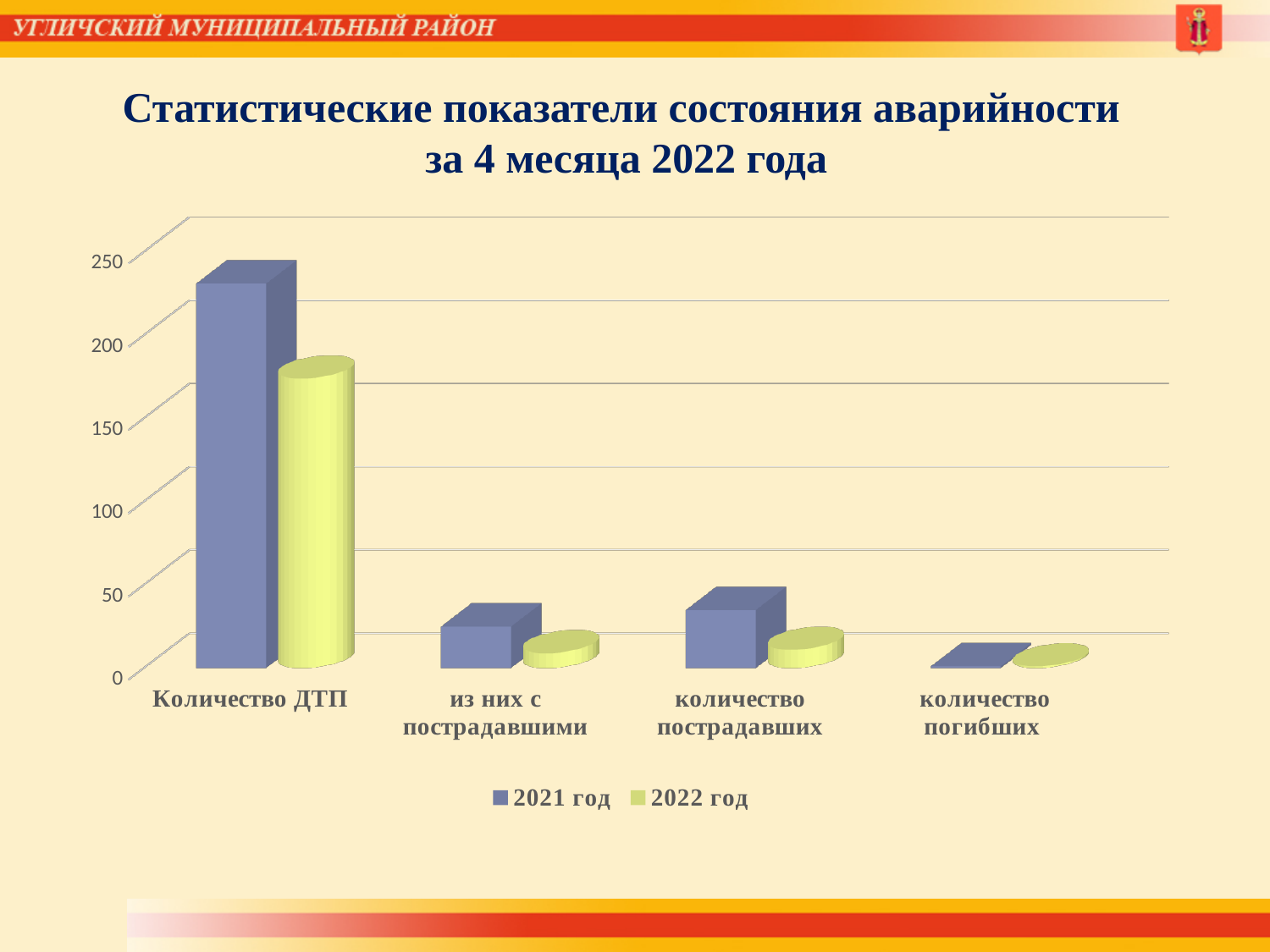
How many categories are shown on the x axis of the chart? 4 For Количество ДТП, which series has the larger value, 2021 год or 2022 год? 2021 год What kind of chart is shown on the slide? bar chart How many series does the chart legend list? 2 Which two series are listed in the chart legend? 2021 год and 2022 год Is the 2021 год value for количество пострадавших greater or less than 50? less Which category has the highest value for the 2021 год series? Количество ДТП Is the 2021 год value for Количество ДТП greater or less than 200? greater Is the 2022 год value for Количество ДТП greater or less than 200? less Which category has the lowest value for the 2022 год series? количество погибших What is the title of the chart on the slide? Статистические показатели состояния аварийности за 4 месяца 2022 года